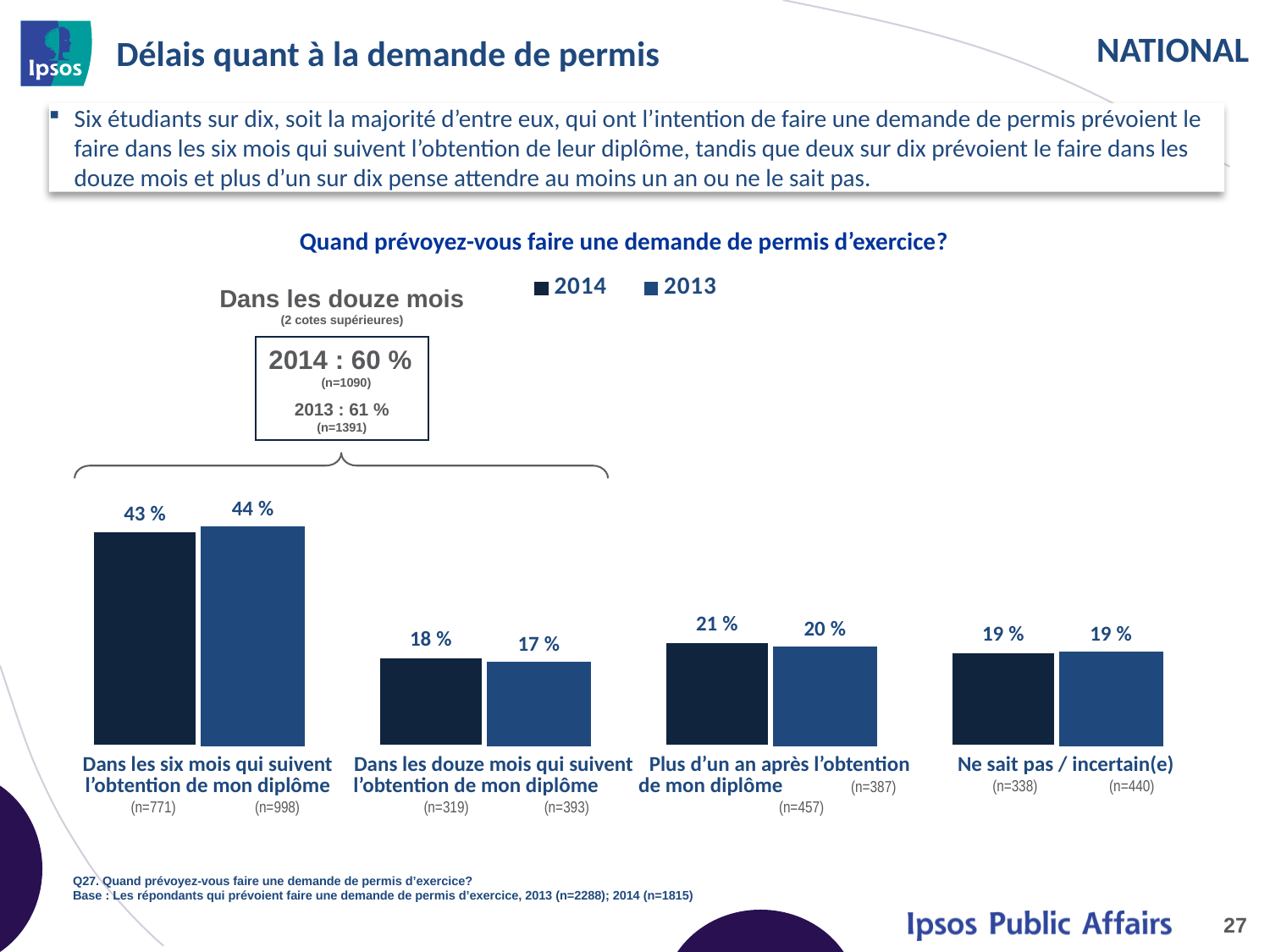
What is the 2013 value for "Dans les douze mois qui suivent l'obtention de mon diplôme"? 17 % What is the 2014 value for "Plus d'un an après l'obtention de mon diplôme"? 21 % For "Plus d'un an après l'obtention de mon diplôme", which year has the larger value, 2014 or 2013? 2014 According to the box above the chart, what is the 2014 value for "Dans les douze mois" (2 cotes supérieures)? 60 % How many categories are shown on the x axis of the chart? 4 What is the 2014 value for "Dans les six mois qui suivent l'obtention de mon diplôme"? 43 % Which category has the highest 2014 value? Dans les six mois qui suivent l'obtention de mon diplôme Which category has the lowest 2013 value? Dans les douze mois qui suivent l'obtention de mon diplôme What is the difference between the 2013 and 2014 values for "Dans les six mois qui suivent l'obtention de mon diplôme"? 1 % How many series does the legend list? 2 What is the 2013 value for "Ne sait pas / incertain(e)"? 19 % What kind of chart is shown on the slide? Bar chart